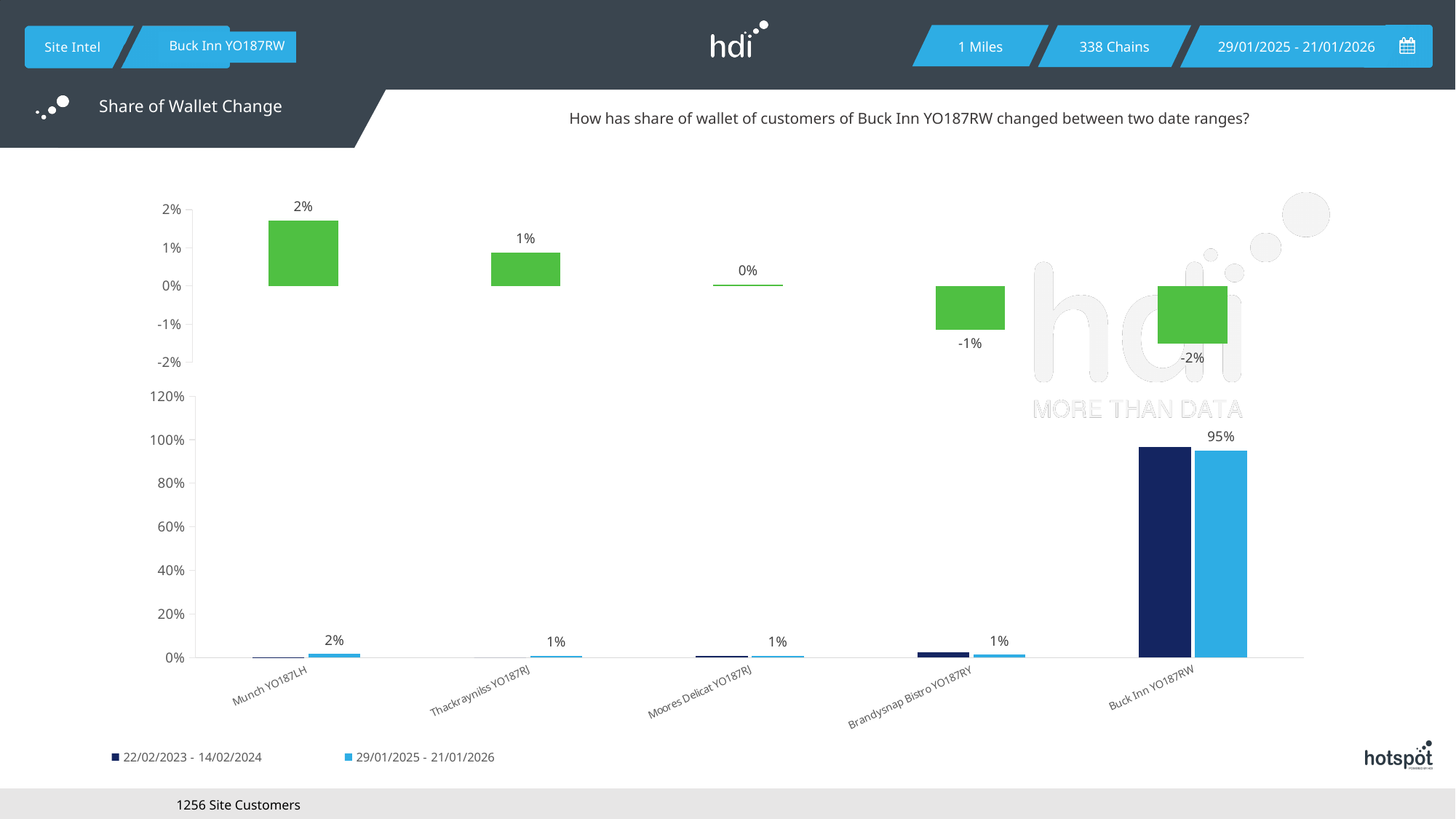
In the bottom chart, is the 22/02/2023 - 14/02/2024 value for Buck Inn YO187RW greater or less than 80%? greater How many series does the legend of the bottom chart list? 2 What kind of chart is the bottom chart? bar chart In the bottom chart, what is the share of wallet for Munch YO187LH in the 29/01/2025 - 21/01/2026 period? 2% In the top chart, what is the share of wallet change for Buck Inn YO187RW? -2% In the top chart, which category has the highest share of wallet change? Munch YO187LH In the top chart, do the values rise or fall moving from left to right along the x axis? fall How many categories are shown on the x axis of the bottom chart? 5 In the top chart, what is the difference between the change for Munch YO187LH and the change for Brandysnap Bistro YO187RY? 3% In the bottom chart, what is the share of wallet for Buck Inn YO187RW in the 29/01/2025 - 21/01/2026 period? 95% In the top chart, which category has the lowest share of wallet change? Buck Inn YO187RW In the top chart, what is the share of wallet change for Munch YO187LH? 2%